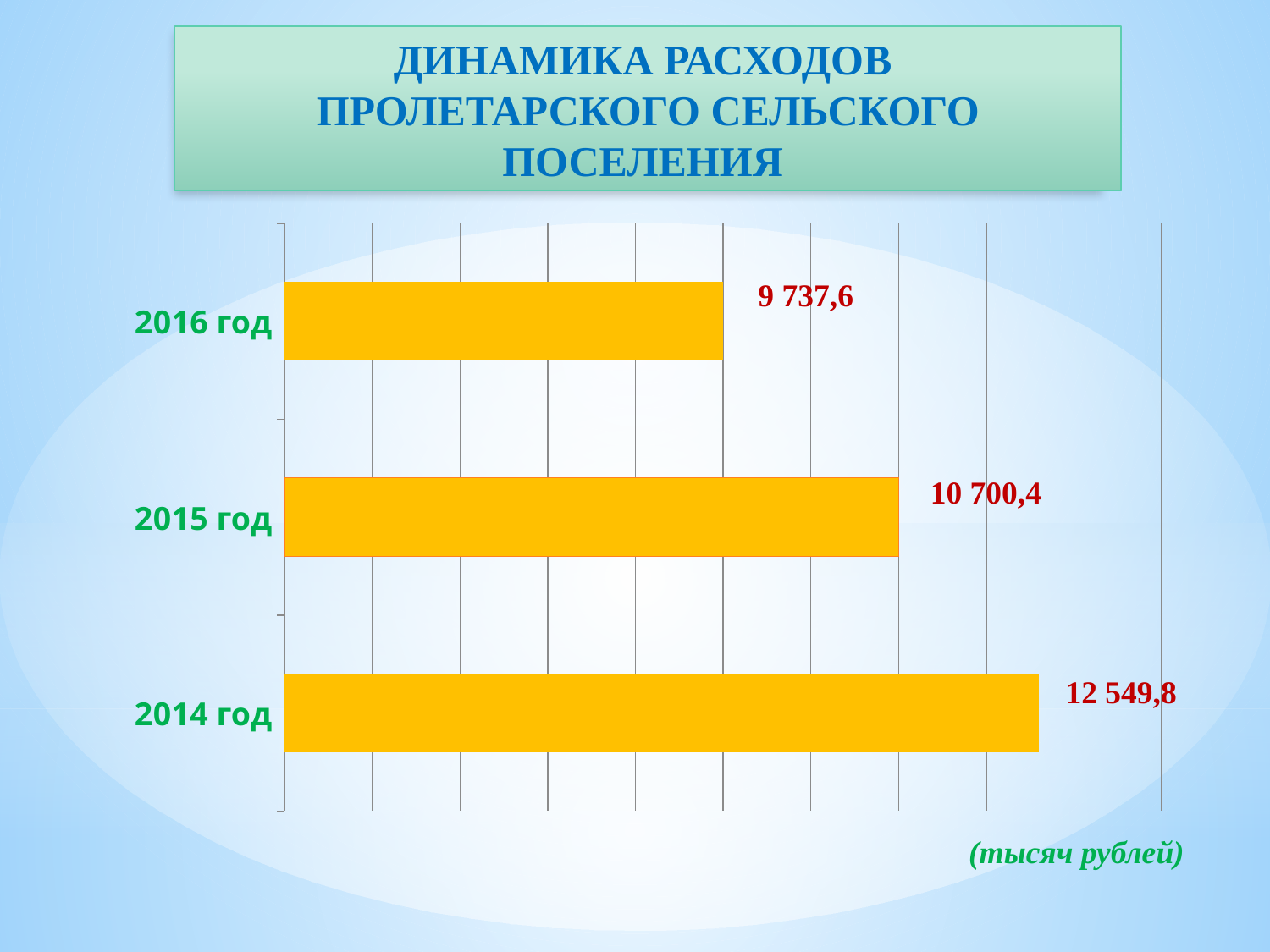
What is the difference between the values for 2015 год and 2016 год? 962,8 Which year has the highest expenditure? 2014 год What is the value for 2016 год? 9 737,6 Do the expenditures rise or fall from 2014 to 2016? Fall Which year has the lowest expenditure? 2016 год What is the difference between the values for 2014 год and 2016 год? 2 812,2 What is the difference between the values for 2014 год and 2015 год? 1 849,4 What is the value for 2015 год? 10 700,4 How many years are shown in the chart? 3 What kind of chart is shown on the slide? Bar chart Which is larger, the value for 2015 год or the value for 2016 год? 2015 год What is the value for 2014 год? 12 549,8